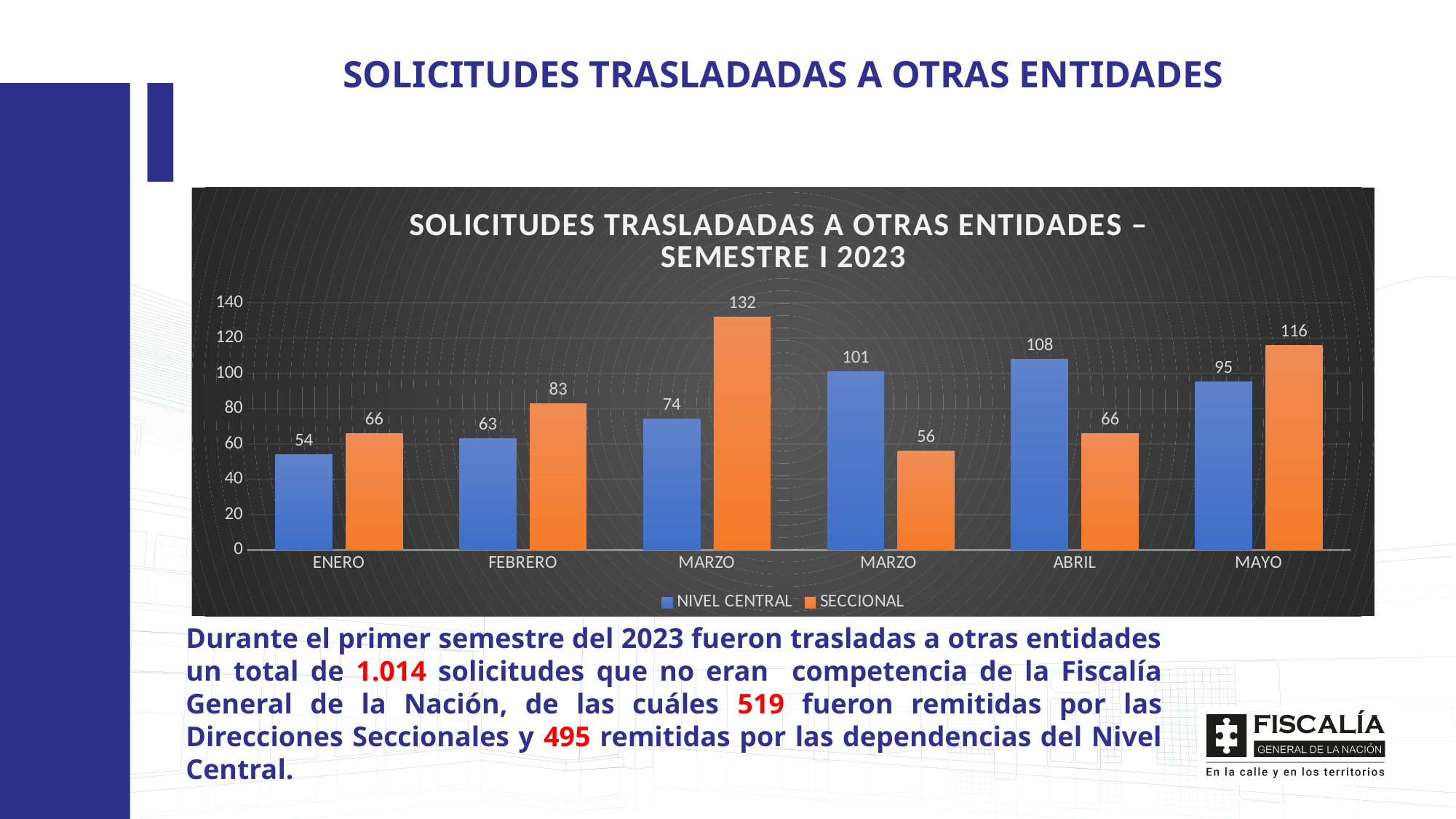
What is the NIVEL CENTRAL value for ABRIL? 108 What is the highest value shown for the SECCIONAL series? 132 What is the combined total of NIVEL CENTRAL and SECCIONAL for ENERO? 120 What is the SECCIONAL value for MAYO? 116 What is the SECCIONAL value for FEBRERO? 83 How many series does the chart legend list? 2 What is the NIVEL CENTRAL value for ENERO? 54 Which category has the lowest NIVEL CENTRAL value? ENERO How many categories are shown on the x axis of the chart? 6 What kind of chart is shown on the slide? Bar chart For ABRIL, what is the difference between the NIVEL CENTRAL value and the SECCIONAL value? 42 For MAYO, which series has the larger value, NIVEL CENTRAL or SECCIONAL? SECCIONAL